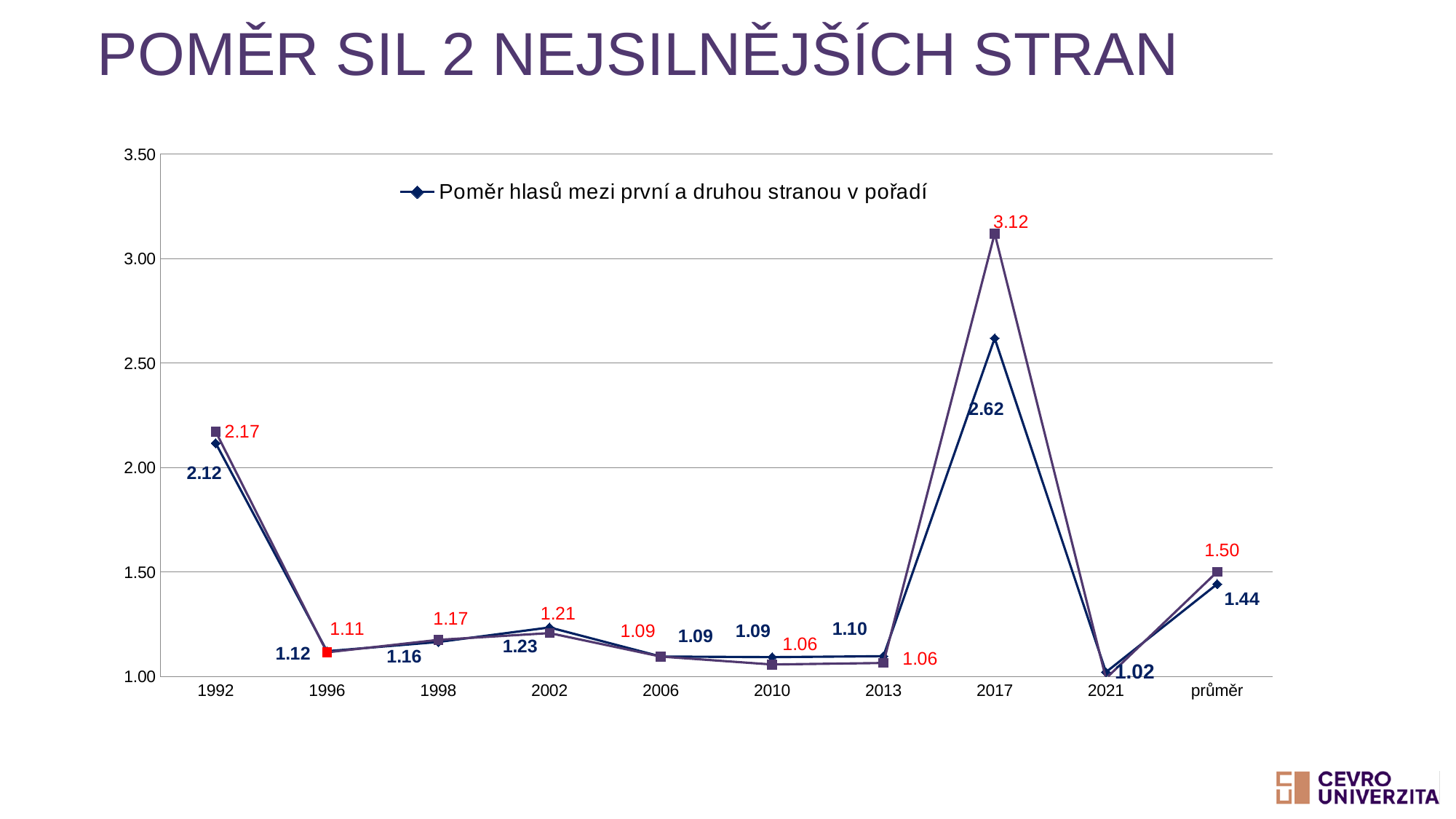
What type of chart is shown on the slide? line chart What is the red-labelled value shown above the 2017 point? 3.12 What is the difference between the 2017 and 2021 values of the series "Poměr hlasů mezi první a druhou stranou v pořadí"? 1.60 What is the value of the series "Poměr hlasů mezi první a druhou stranou v pořadí" for průměr? 1.44 How many series does the legend list? 1 What is the value of the series "Poměr hlasů mezi první a druhou stranou v pořadí" for 2017? 2.62 Which is larger for the series "Poměr hlasů mezi první a druhou stranou v pořadí": the value for 1992 or the value for 2002? 1992 What is the value of the series "Poměr hlasů mezi první a druhou stranou v pořadí" for 1992? 2.12 What is the value of the series "Poměr hlasů mezi první a druhou stranou v pořadí" for 2021? 1.02 In which year does the series "Poměr hlasů mezi první a druhou stranou v pořadí" reach its lowest value? 2021 In which year does the series "Poměr hlasů mezi první a druhou stranou v pořadí" reach its highest value? 2017 How many categories are shown on the x axis? 10